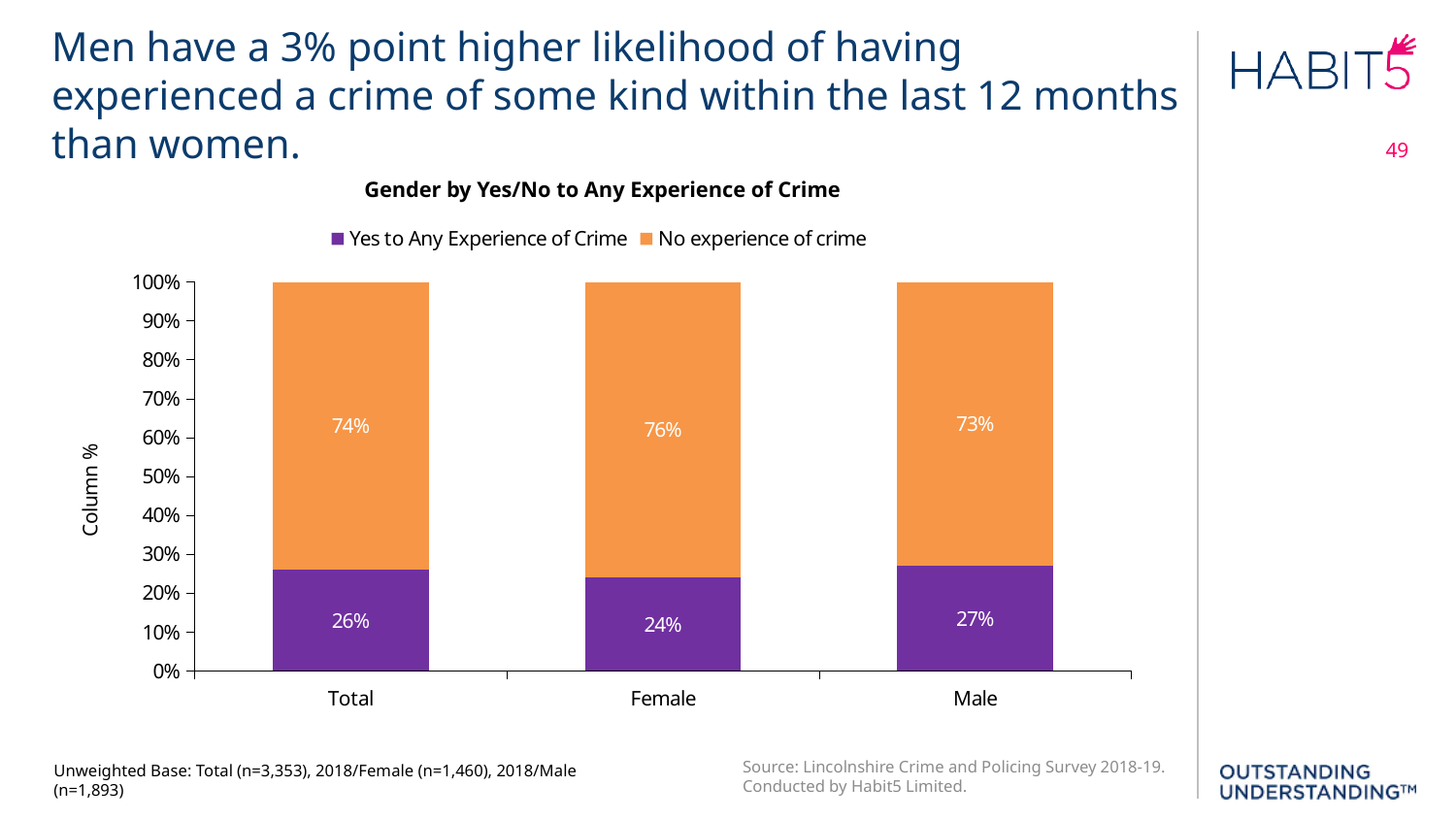
What percentage of Female respondents had No experience of crime? 76% What is the difference in percentage points between Male and Female for Yes to Any Experience of Crime? 3 Which category has the lowest value for No experience of crime? Male What kind of chart is shown on the slide? Stacked bar chart What is the value for Yes to Any Experience of Crime in the Total category? 26% Which category has the highest value for Yes to Any Experience of Crime? Male What percentage of Male respondents said Yes to Any Experience of Crime? 27% What is the title of the chart? Gender by Yes/No to Any Experience of Crime Which is larger: the No experience of crime value for Female or for Total? Female How many series does the legend list? 2 How many categories are shown on the x axis? 3 What is the total of the stacked bar for Female? 100%